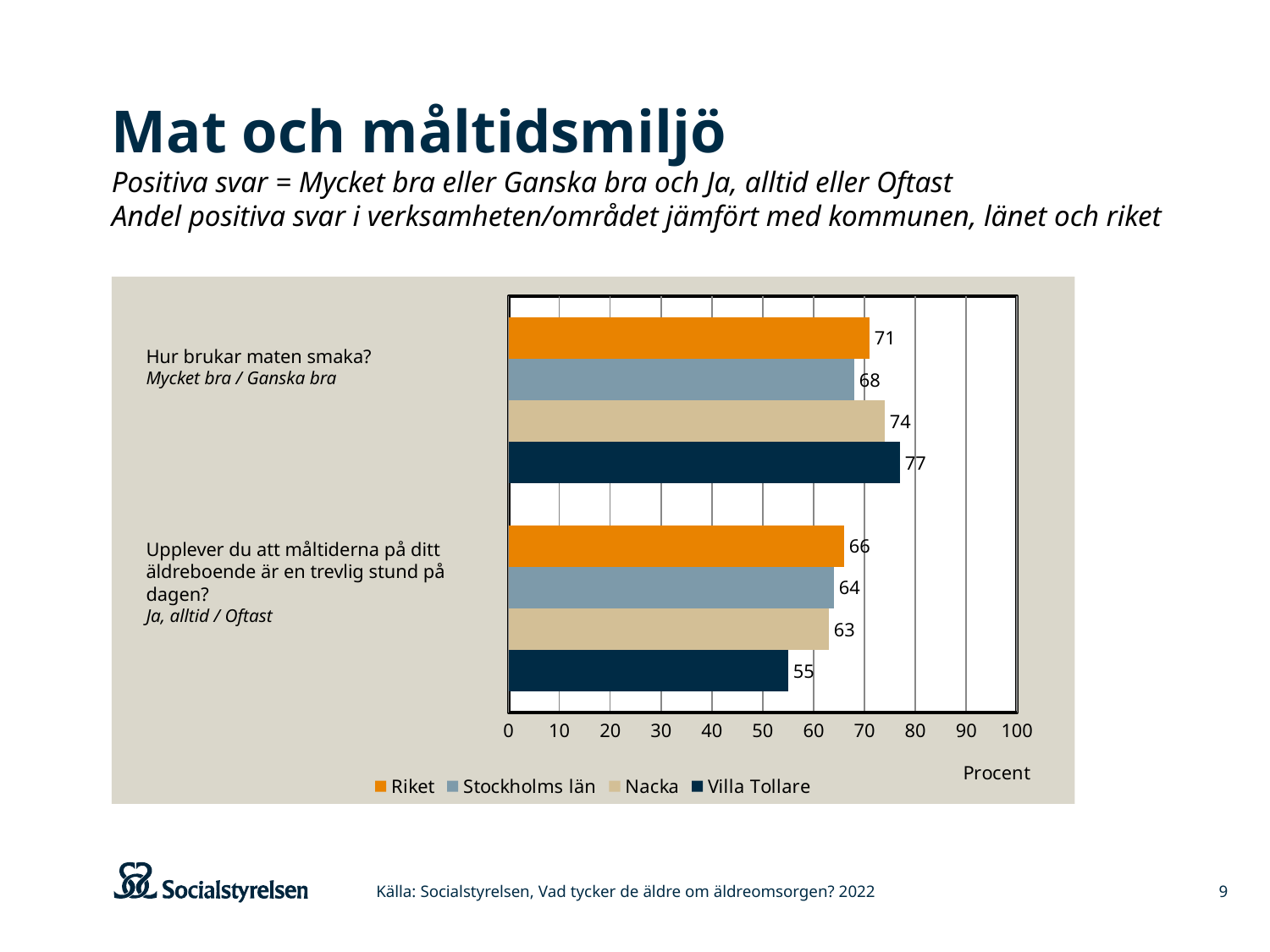
How many series does the legend list? 4 What kind of chart is shown on the slide? Bar chart Which series has the highest value for "Hur brukar maten smaka?"? Villa Tollare Which series has the lowest value for "Upplever du att måltiderna på ditt äldreboende är en trevlig stund på dagen?"? Villa Tollare What is the value for Villa Tollare on "Hur brukar maten smaka?"? 77 What is the difference between Villa Tollare's values for "Hur brukar maten smaka?" and "Upplever du att måltiderna på ditt äldreboende är en trevlig stund på dagen?"? 22 What is the value for Nacka on "Hur brukar maten smaka?"? 74 What is the value for Stockholms län on "Upplever du att måltiderna på ditt äldreboende är en trevlig stund på dagen?"? 64 What unit label is shown on the x axis of the chart? Procent Is the value for Nacka on "Upplever du att måltiderna på ditt äldreboende är en trevlig stund på dagen?" greater or less than 70? less Which is larger for "Hur brukar maten smaka?": Riket or Stockholms län? Riket What is the value for Riket on "Upplever du att måltiderna på ditt äldreboende är en trevlig stund på dagen?"? 66